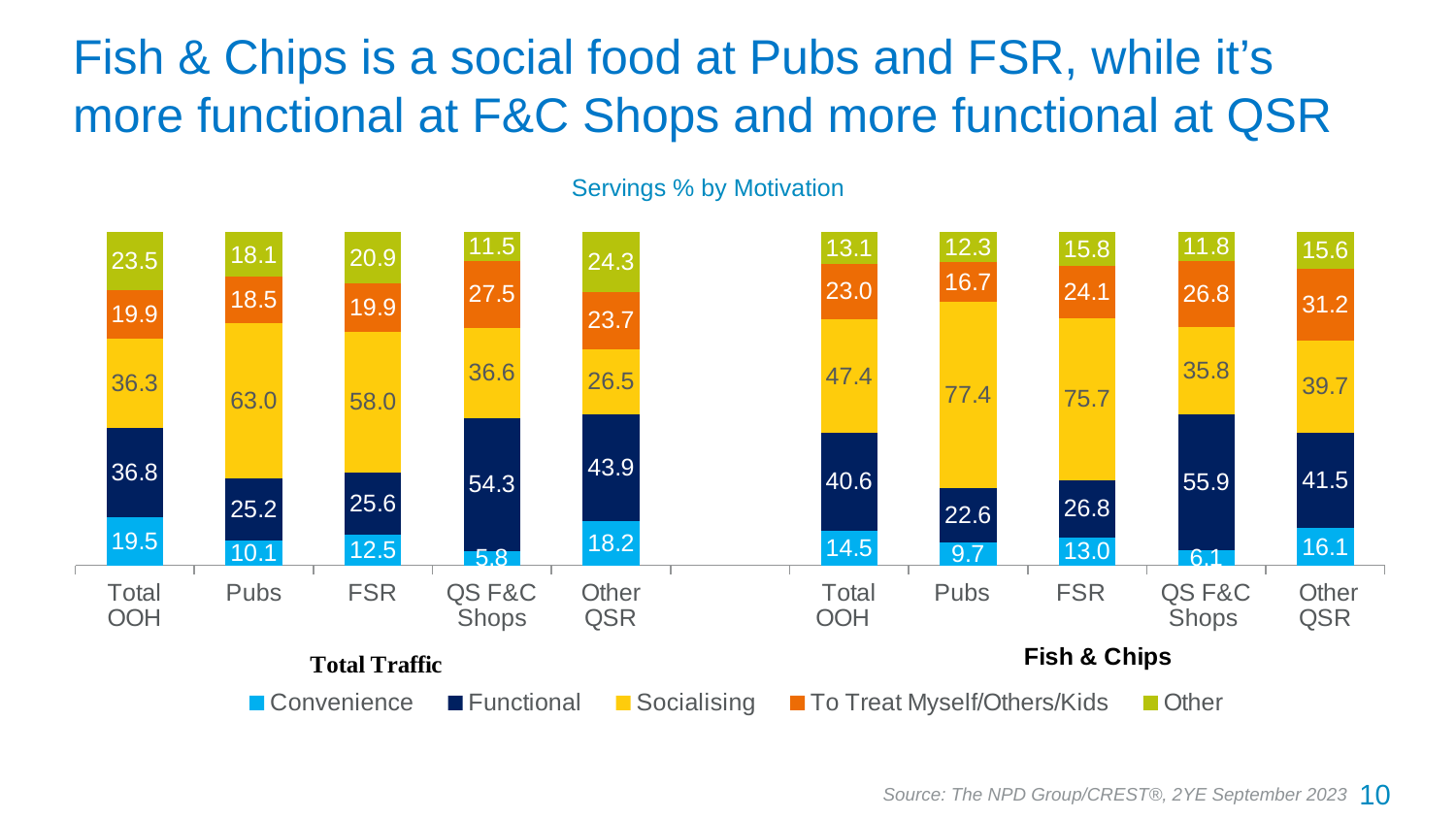
How many categories are shown on the x axis of the Fish & Chips chart? 5 How many series does the legend list? 5 In the Fish & Chips chart, which category has the highest Functional value? QS F&C Shops In the Total Traffic chart, which category has the highest Socialising value? Pubs In the Fish & Chips chart, what is the To Treat Myself/Others/Kids value for Other QSR? 31.2 In the Fish & Chips chart, which category has the lowest Convenience value? QS F&C Shops What kind of chart is used on this slide? Stacked bar chart In the Total Traffic chart, which has the larger Functional value, Other QSR or Total OOH? Other QSR In the Total Traffic chart, what is the difference between the Convenience values for Total OOH and Pubs? 9.4 In the Fish & Chips chart, what is the Socialising value for Pubs? 77.4 In the Total Traffic chart, what is the Functional value for QS F&C Shops? 54.3 In the Fish & Chips chart, what is the difference between the Socialising values for Pubs and FSR? 1.7